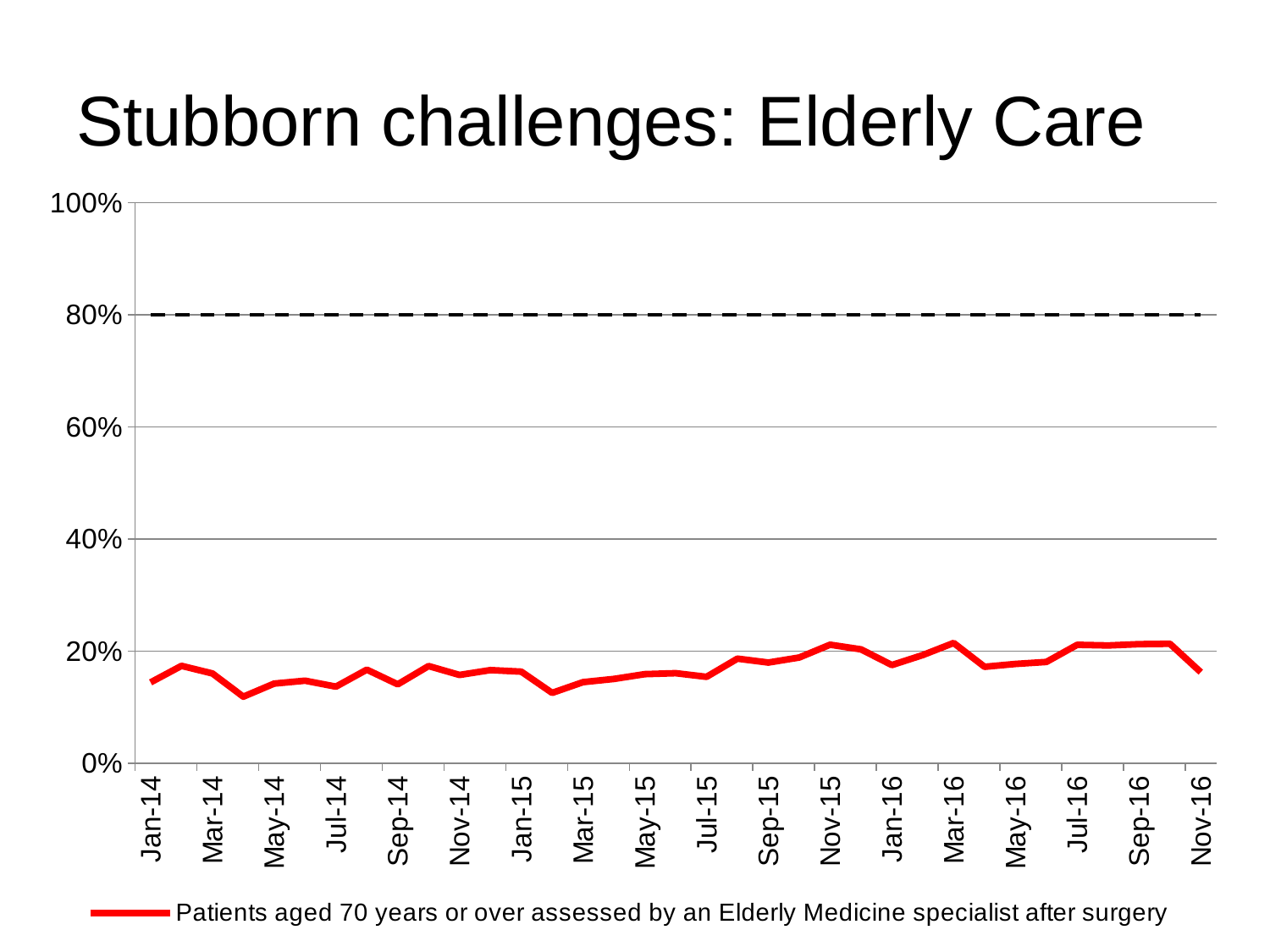
What is the title of the slide? Stubborn challenges: Elderly Care Which is larger, the value for Mar-14 or the value for Jul-16? Jul-16 At what percentage level is the dashed horizontal line drawn? 80% Is the value for Mar-14 greater or less than 20%? less Is the value for Nov-16 greater or less than 80%? less What series does the legend name? Patients aged 70 years or over assessed by an Elderly Medicine specialist after surgery What kind of chart is shown on the slide? line chart How many series does the legend list? 1 Does the red line ever reach the dashed 80% line? No Which is larger, the value for Jan-14 or the value for Mar-16? Mar-16